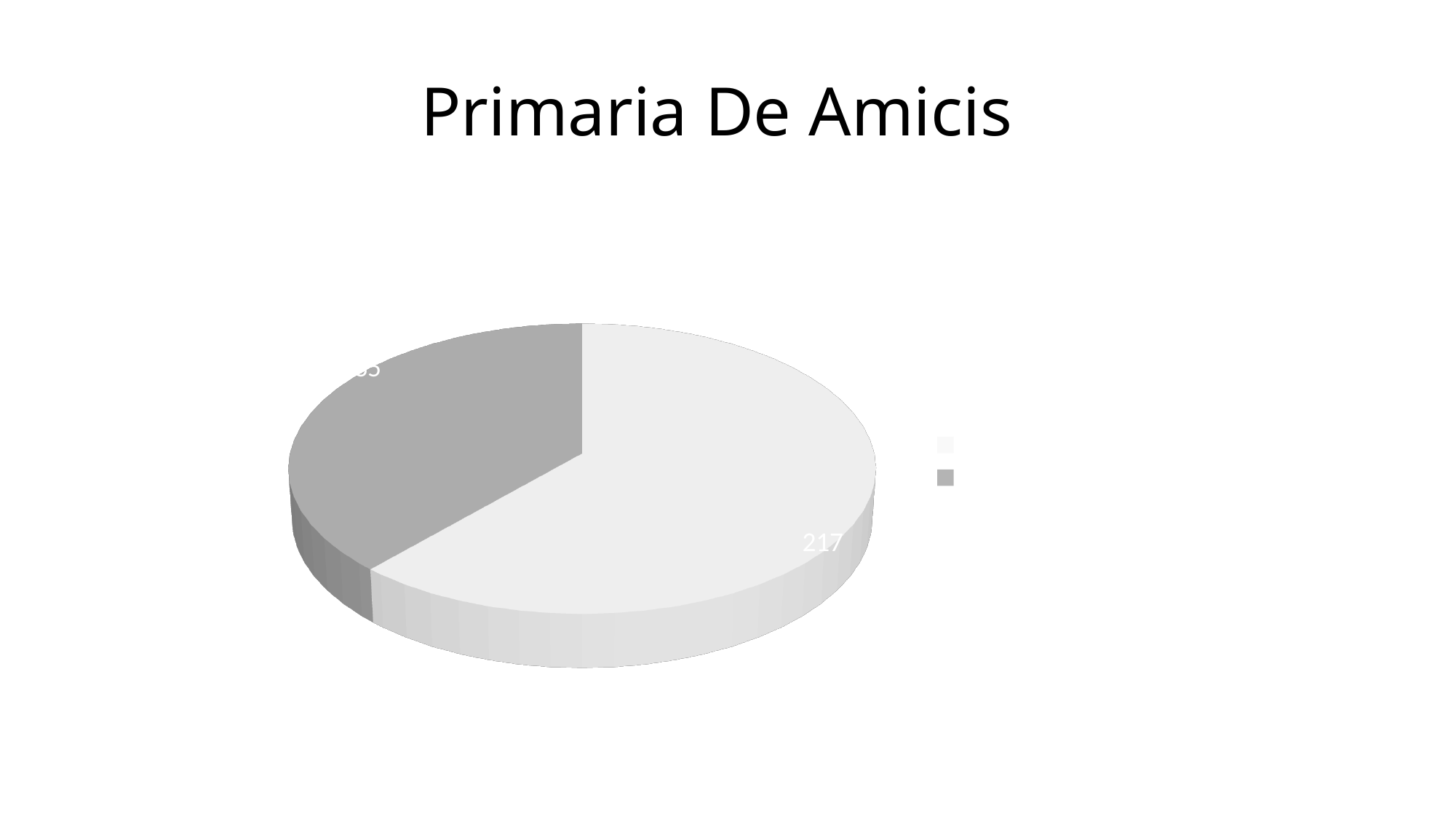
Which slice of the pie chart is the smallest? the dark grey slice How many entries does the legend show? 2 How many slices does the pie chart have? 2 What kind of chart is shown on the slide? pie chart Is the share of the light grey slice greater or less than 50% of the pie? greater Is the light grey slice larger or smaller than the dark grey slice? larger Which slice of the pie chart is the largest? the light grey slice What value is labelled on the light grey slice of the pie chart? 217 What is the title of the chart? Primaria De Amicis